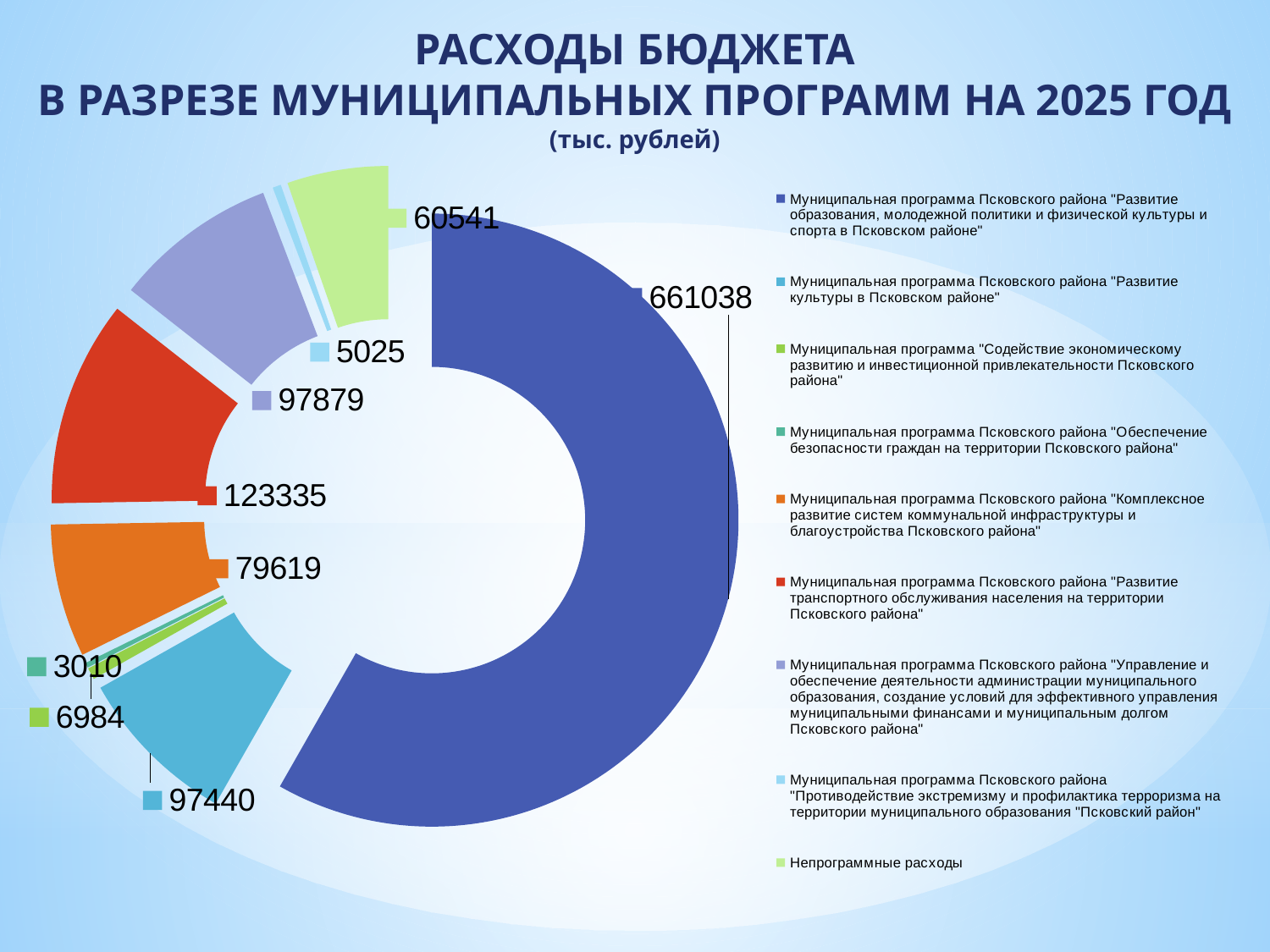
What is the value for the municipal program "Развитие транспортного обслуживания населения на территории Псковского района"? 123335 What is the value for the municipal program "Развитие образования, молодежной политики и физической культуры и спорта в Псковском районе"? 661038 Which category has the smallest value on the chart? Муниципальная программа Псковского района "Обеспечение безопасности граждан на территории Псковского района" Which is larger: the value for the culture program or the value for the communal infrastructure program? The culture program (97440) In what units are the values on the chart given, according to the title? тыс. рублей Which program has the largest expenditure? Муниципальная программа Псковского района "Развитие образования, молодежной политики и физической культуры и спорта в Псковском районе" What kind of chart is shown on the slide? Doughnut (pie) chart What is the difference between the transport program (123335) and the communal infrastructure program (79619)? 43716 What is the value for the municipal program "Обеспечение безопасности граждан на территории Псковского района"? 3010 How many entries does the legend list? 9 How many categories (slices) does the chart contain? 9 What is the value for "Непрограммные расходы"? 60541